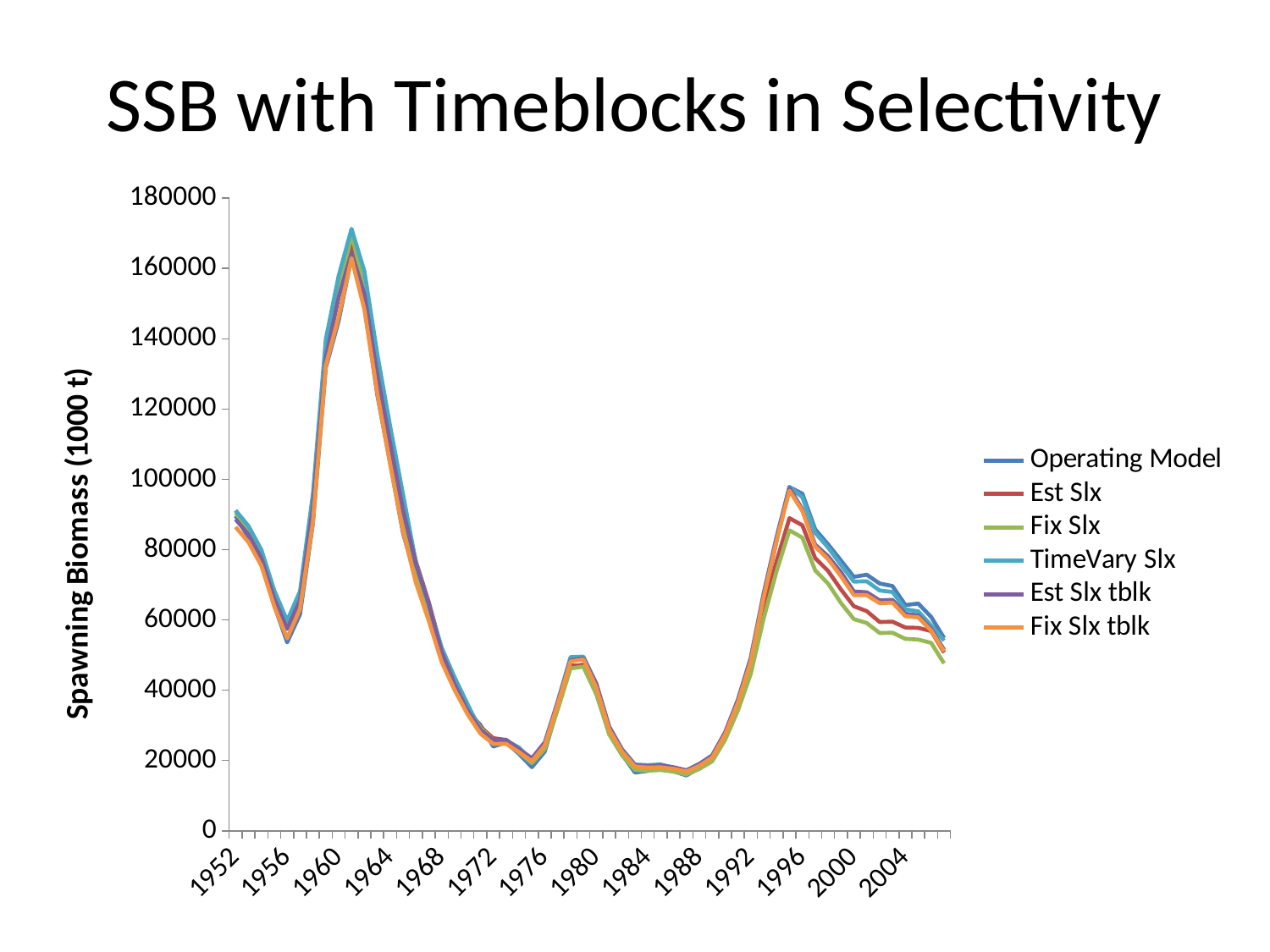
Is the value for Fix Slx in 2000 greater or less than 80000? less Is the value for the Operating Model in 1976 greater or less than 40000? less What kind of chart is shown on the slide? line chart How many series does the legend list? 6 Is the value for the Operating Model in 1962 greater or less than 140000? greater In 2004, which is larger: the Operating Model value or the Fix Slx value? Operating Model Do the values rise or fall between 1988 and 1996? rise Do the values rise or fall between 1964 and 1976? fall What is the title of the chart? SSB with Timeblocks in Selectivity What is the label on the vertical axis? Spawning Biomass (1000 t) Which series has the lowest value at the right end of the chart (around 2006)? Fix Slx